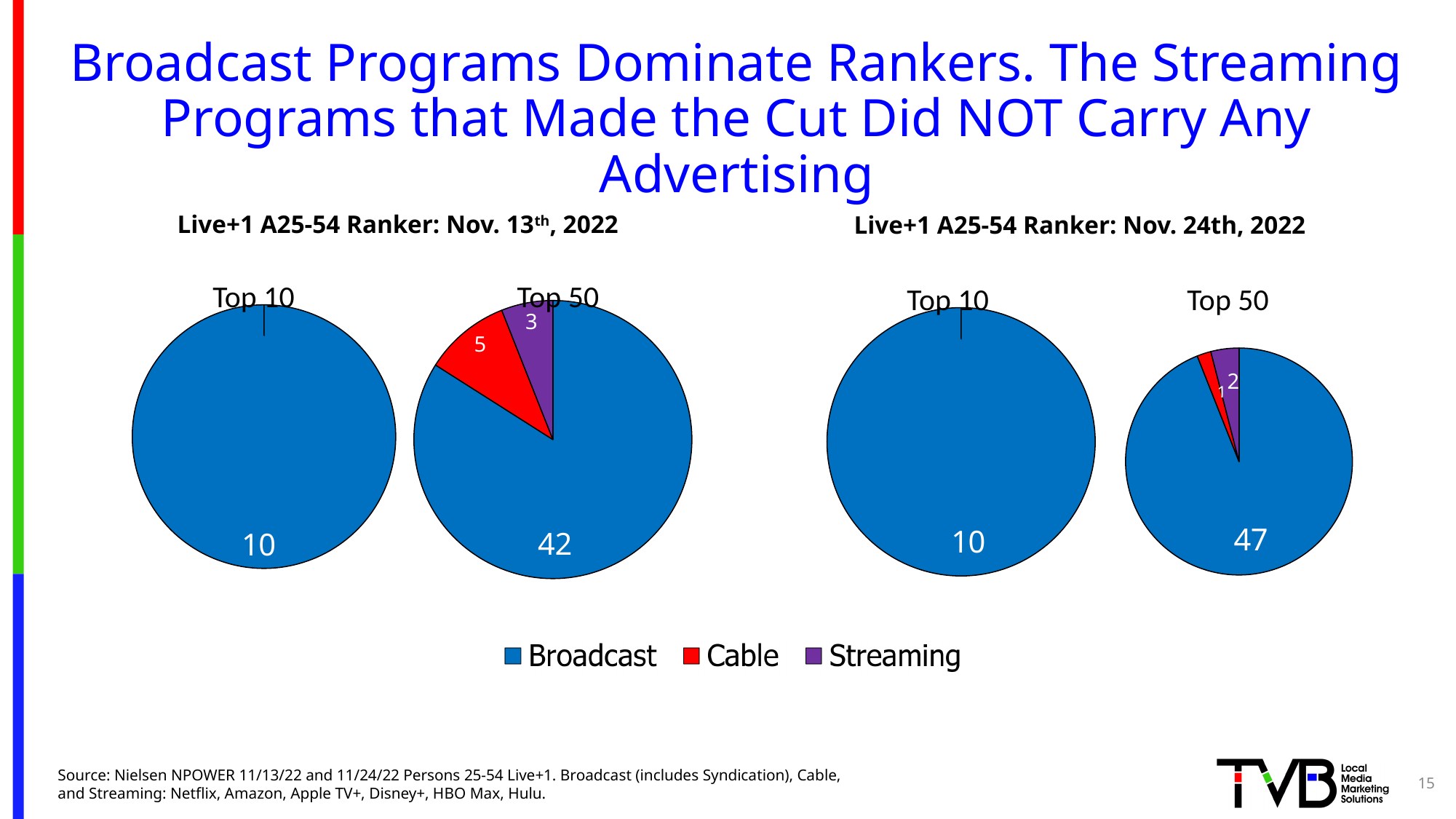
What kind of chart is used on this slide? Pie chart How many series does the legend list? 3 In the Nov. 13th, 2022 Top 50 pie chart, what share of the pie is Broadcast? 84% In the Nov. 13th, 2022 Top 50 pie chart, how many programs are Cable? 5 In the Nov. 24th, 2022 Top 50 pie chart, how many programs are Broadcast? 47 In the Nov. 13th, 2022 Top 50 pie chart, which category has the largest slice? Broadcast In the Nov. 13th, 2022 Top 50 pie chart, which is larger, Cable or Streaming? Cable In the Nov. 13th, 2022 Top 50 pie chart, what is the difference between the Broadcast and Cable counts? 37 In the Nov. 13th, 2022 Top 50 pie chart, how many programs are Broadcast? 42 In the Nov. 13th, 2022 Top 10 pie chart, how many programs are Broadcast? 10 In the Nov. 24th, 2022 Top 50 pie chart, how many programs are Streaming? 2 In the Nov. 24th, 2022 Top 50 pie chart, which category has the smallest slice? Cable